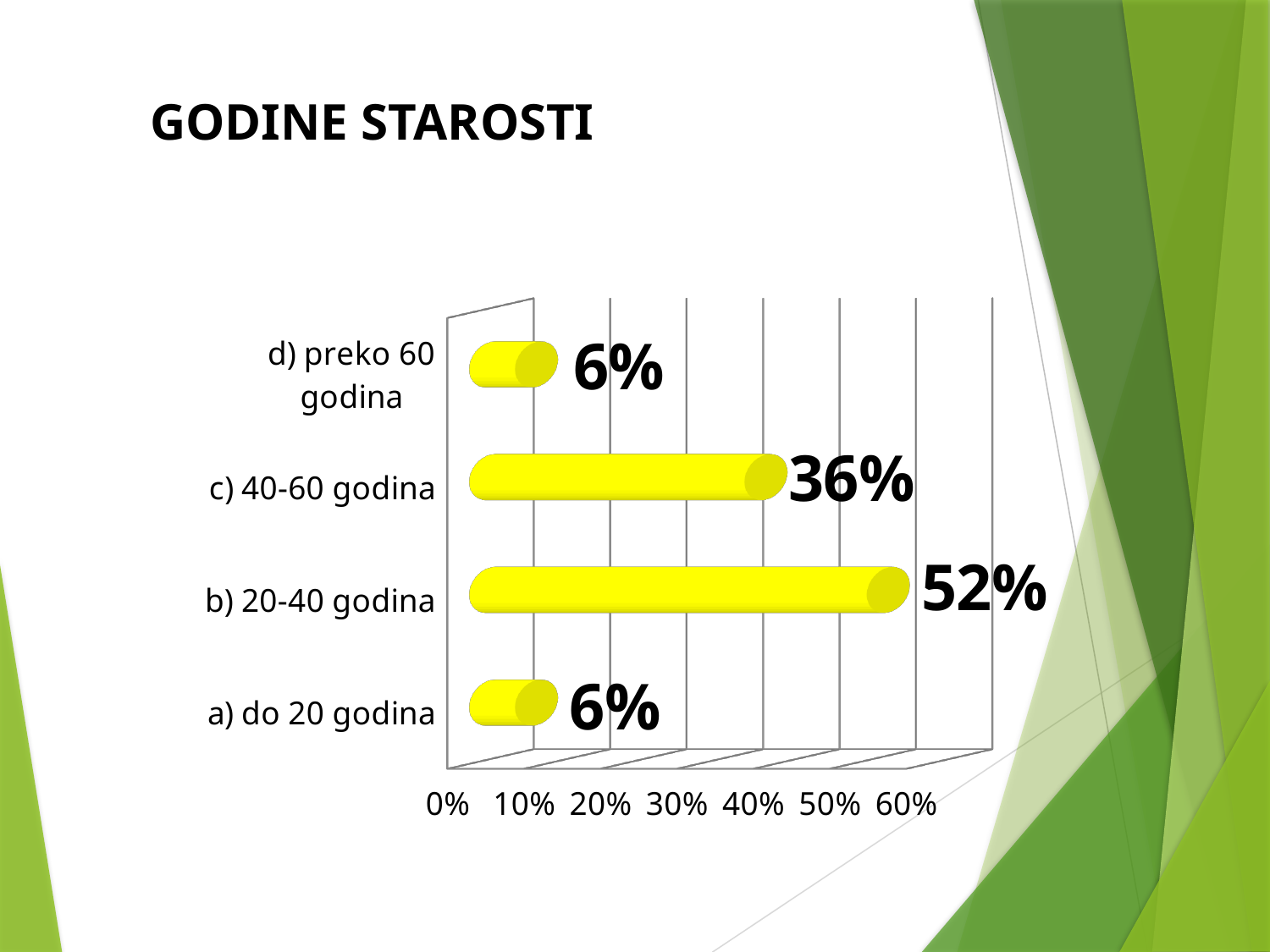
What is the title of the slide? GODINE STAROSTI Which is larger, the value for c) 40-60 godina or the value for d) preko 60 godina? c) 40-60 godina What is the difference between the values for c) 40-60 godina and a) do 20 godina? 30% What is the value for d) preko 60 godina? 6% What is the value for b) 20-40 godina? 52% What is the value for a) do 20 godina? 6% How many categories are shown in the chart? 4 What is the difference between the values for b) 20-40 godina and c) 40-60 godina? 16% Which category has the highest value? b) 20-40 godina What is the value for c) 40-60 godina? 36% Is the value for b) 20-40 godina greater or less than 50%? greater What kind of chart is shown on the slide? bar chart